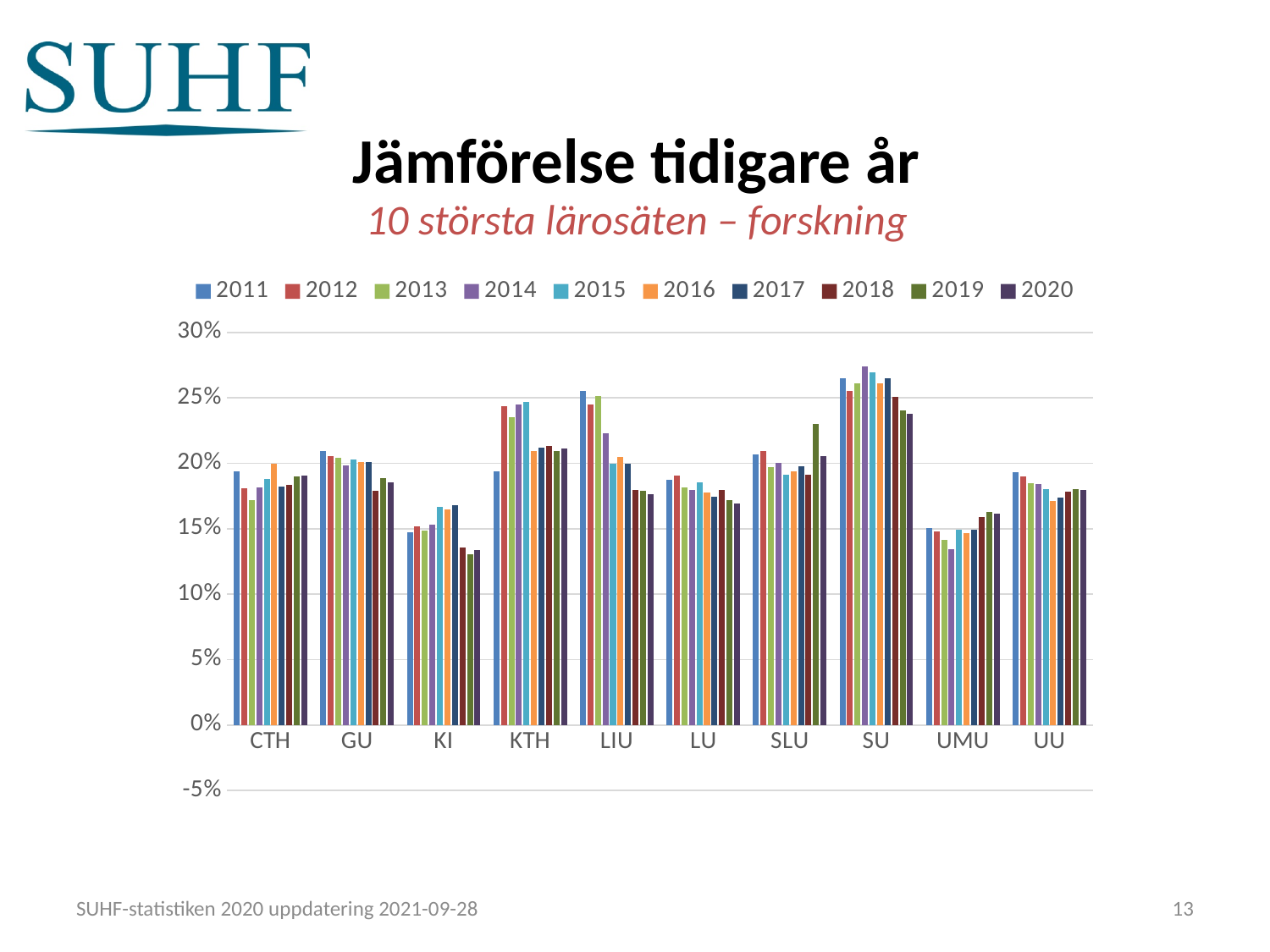
How many institutions (categories) are shown on the x axis? 10 Do the values for SU rise or fall from 2014 to 2020? fall Is the value for SU in 2014 greater or less than 25%? greater What kind of chart is shown on the slide? bar chart Is the value for SLU in 2019 greater or less than 20%? greater Is the value for UMU in 2014 greater or less than 15%? less How many series (years) does the legend list? 10 What is the subtitle shown under the chart title? 10 största lärosäten – forskning Which institution has the lowest bar in the chart? KI Which institution has the highest bar in the chart? SU Which is larger in 2020, the value for SU or the value for UMU? SU